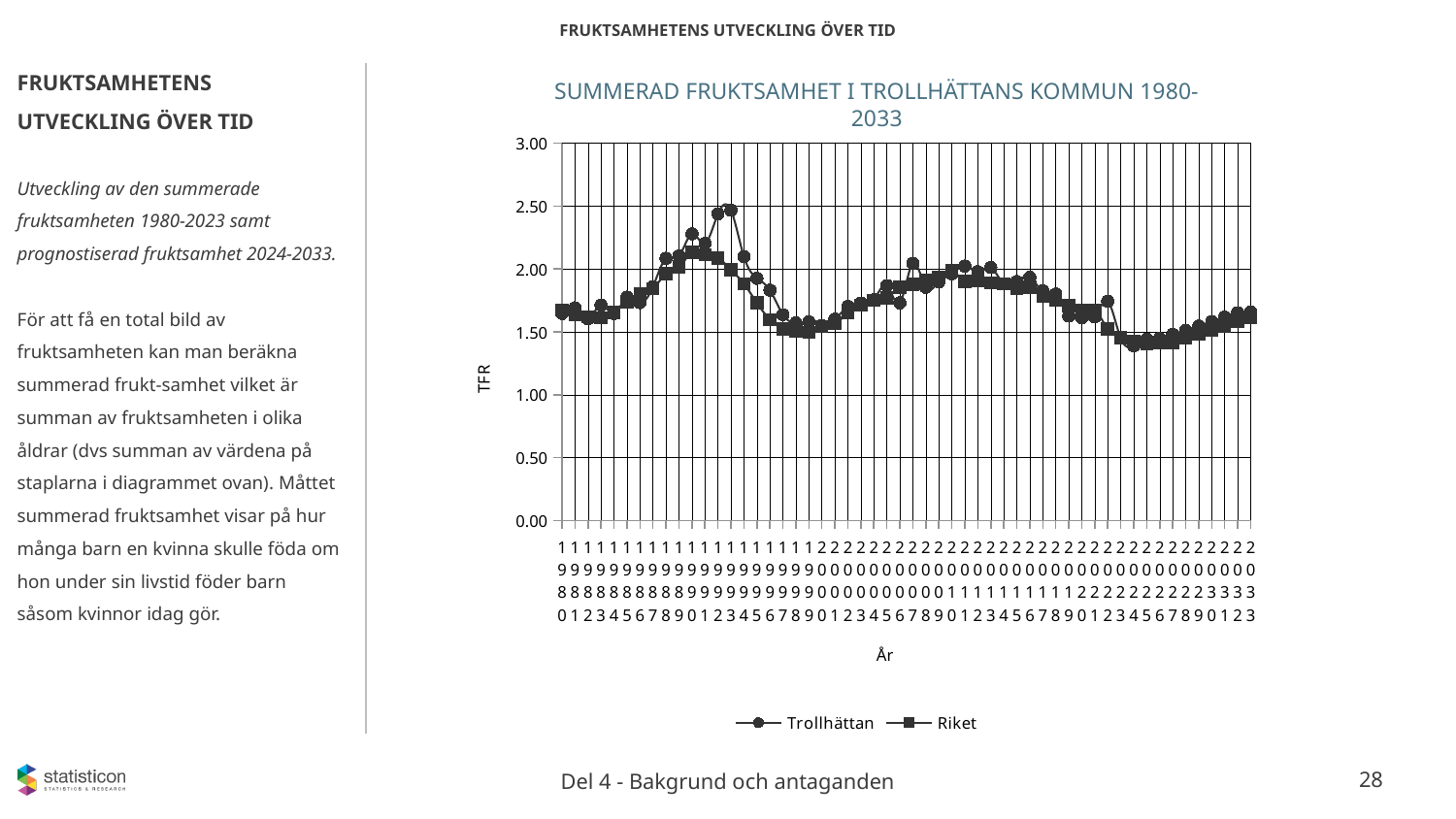
Does the Trollhättan series rise or fall between 1980 and 1992? rise Is the value for Riket in 2021 greater or less than 2.00? less What kind of chart is shown on the slide? Line chart What are the two series named in the legend? Trollhättan and Riket Is the value for Trollhättan in 1993 greater or less than 2.00? greater Does the Riket series rise or fall between 2010 and 2021? fall What is the label on the vertical axis? TFR Is the value for Trollhättan in 2010 greater or less than 1.50? greater How many series does the legend list? 2 How many years are plotted along the x axis? 54 What is the title of the chart? Summerad fruktsamhet i Trollhättans kommun 1980-2033